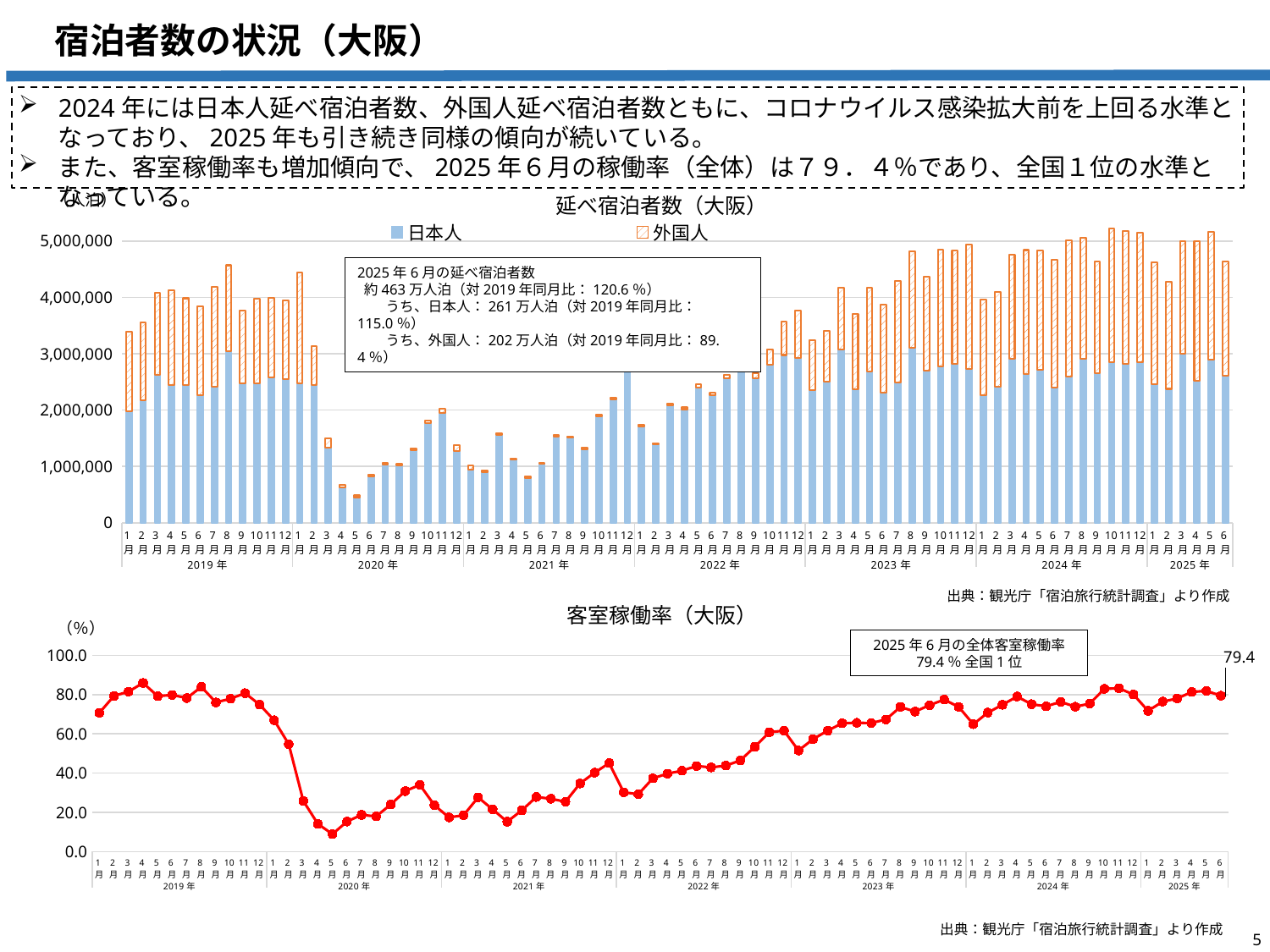
In the top chart 延べ宿泊者数（大阪）, is the total for 2020年5月 greater or less than 1,000,000? less In the top chart 延べ宿泊者数（大阪）, which month has the lowest total stacked bar? 2020年5月 What kind of chart is the top chart titled 延べ宿泊者数（大阪）? stacked bar chart According to the annotation box on the top chart, what is the total 延べ宿泊者数 for 2025年6月? 約463万人泊 In the top chart 延べ宿泊者数（大阪）, how many series does the legend list? 2 In the bottom chart 客室稼働率（大阪）, what is the labelled value for 2025年6月? 79.4 In the top chart 延べ宿泊者数（大阪）, what are the two legend entries? 日本人, 外国人 In the bottom chart 客室稼働率（大阪）, which month has the lowest occupancy rate? 2020年5月 In the bottom chart 客室稼働率（大阪）, is the value for 2020年5月 greater or less than 20.0? less In the top chart 延べ宿泊者数（大阪）, do the total bars rise or fall from 2020年1月 to 2020年5月? fall What kind of chart is the bottom chart titled 客室稼働率（大阪）? line chart In the top chart 延べ宿泊者数（大阪）, is the total for 2019年8月 greater or less than 4,000,000? greater